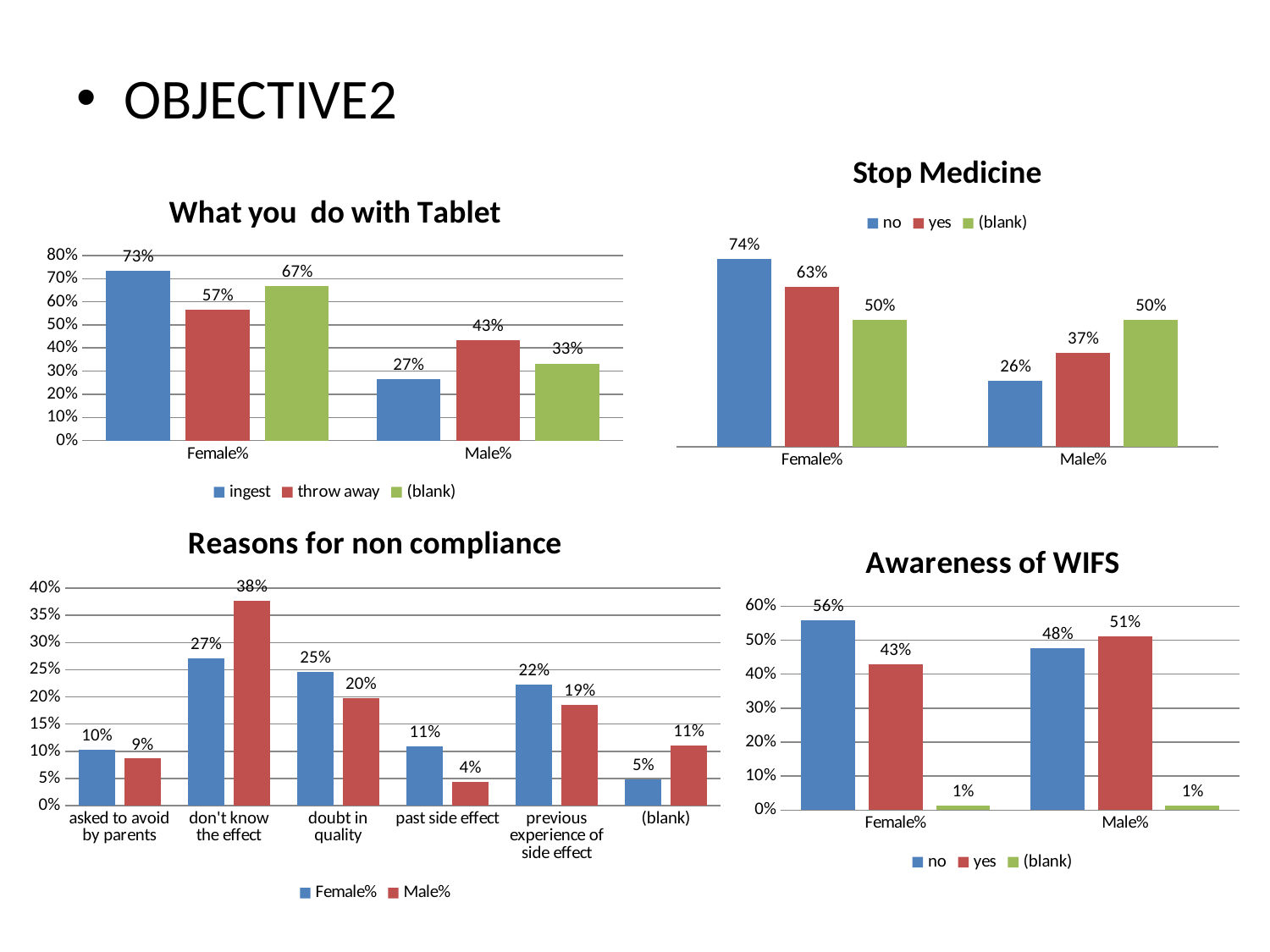
In the 'Reasons for non compliance' chart, how many categories are shown on the x axis? 6 In the 'Stop Medicine' chart, what is the value for 'yes' for Male%? 37% In the 'Reasons for non compliance' chart, which category has the highest Male% value? don't know the effect In the 'Reasons for non compliance' chart, which is larger for 'doubt in quality', Female% or Male%? Female% In the 'Reasons for non compliance' chart, what is the Female% value for 'past side effect'? 11% In the 'Stop Medicine' chart, which series has the highest value for Female%? no In the 'Awareness of WIFS' chart, what is the value for 'yes' for Male%? 51% In the 'Awareness of WIFS' chart, what is the difference between 'no' and 'yes' for Female%? 13% What kind of chart is the 'Awareness of WIFS' chart? bar chart In the 'Stop Medicine' chart, how many series does the legend list? 3 In the 'What you do with Tablet' chart, what is the difference between the 'ingest' values for Female% and Male%? 46% In the 'What you do with Tablet' chart, what is the value for 'throw away' for Female%? 57%